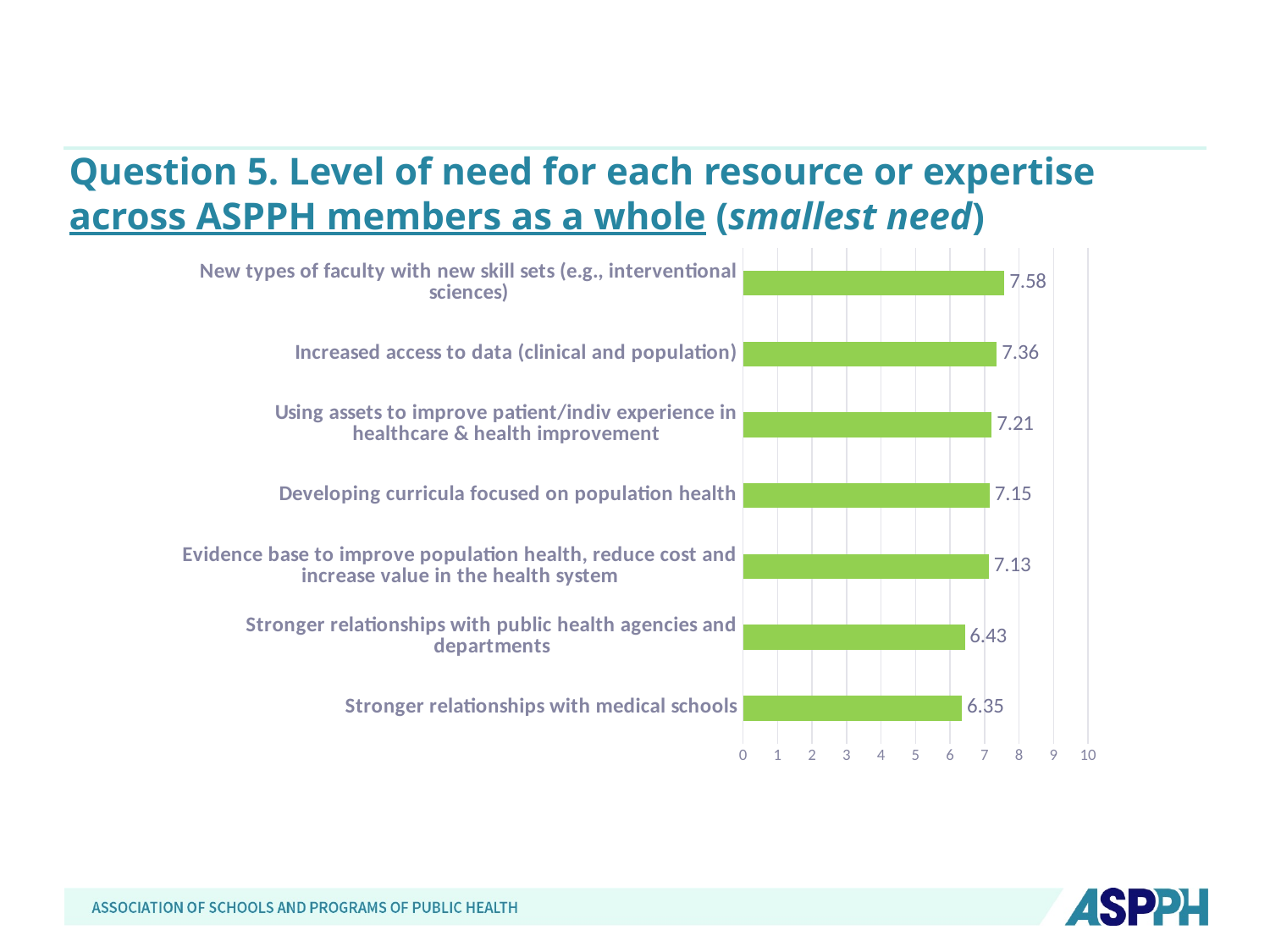
What is the value for "Developing curricula focused on population health"? 7.15 Which category has the highest value? New types of faculty with new skill sets (e.g., interventional sciences) Is the value for "Stronger relationships with public health agencies and departments" greater or less than 7? less What is the value for "Increased access to data (clinical and population)"? 7.36 What is the difference between the values for "New types of faculty with new skill sets (e.g., interventional sciences)" and "Stronger relationships with medical schools"? 1.23 How many categories are shown in the chart? 7 What is the value for "Stronger relationships with medical schools"? 6.35 Which is larger: the value for "Increased access to data (clinical and population)" or the value for "Stronger relationships with public health agencies and departments"? Increased access to data (clinical and population) Which category has the lowest value? Stronger relationships with medical schools What is the maximum value shown on the horizontal axis? 10 What colour are the bars in the chart? Green What kind of chart is shown on the slide? Bar chart